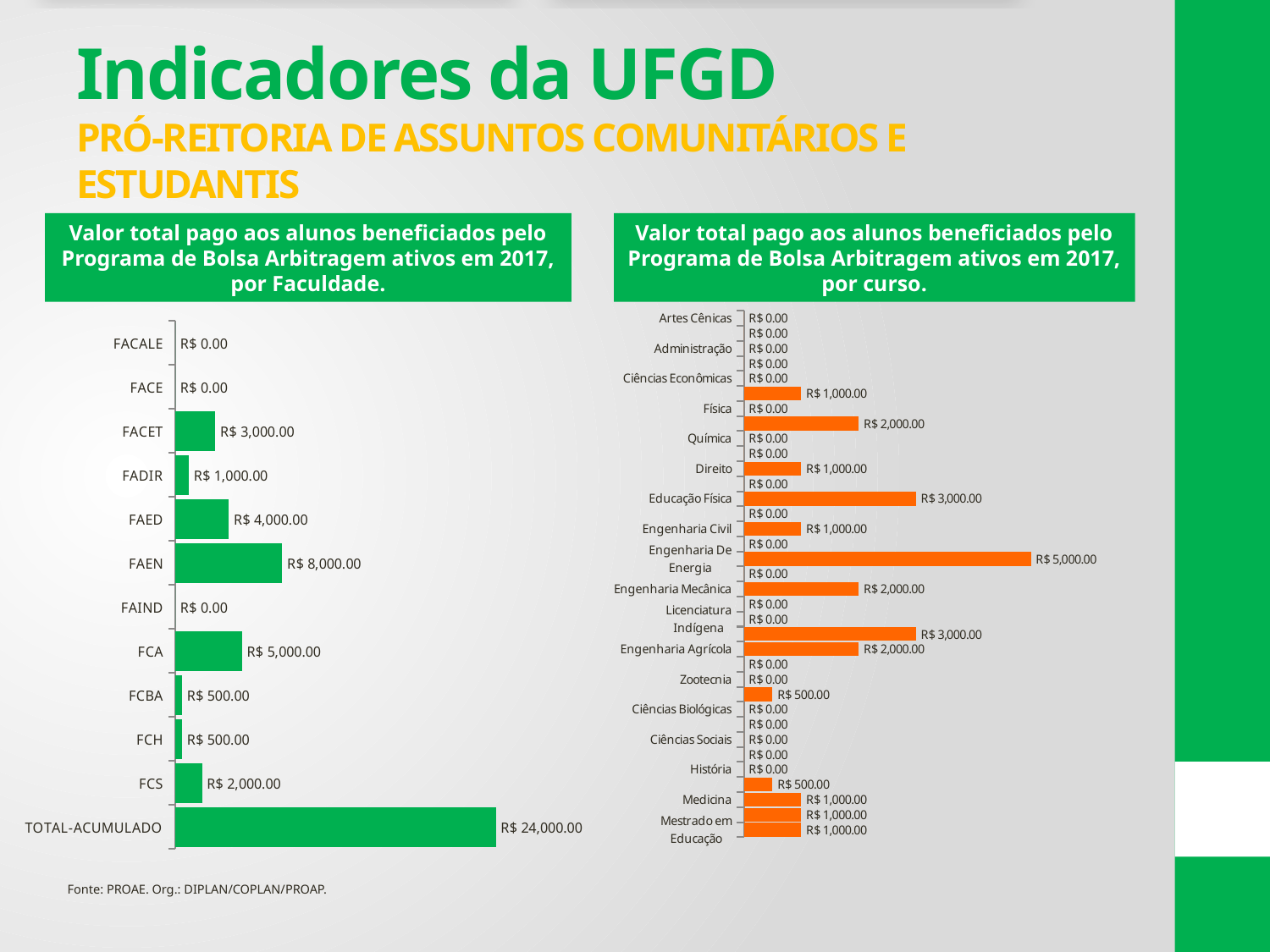
In the left chart (por Faculdade), which faculty, excluding TOTAL-ACUMULADO, has the highest value? FAEN In the left chart (por Faculdade), what is the value for TOTAL-ACUMULADO? R$ 24,000.00 In the left chart (por Faculdade), how many categories are plotted, including TOTAL-ACUMULADO? 12 In the left chart (por Faculdade), what is the difference between the values for FAEN and FCA? R$ 3,000.00 In the left chart (por Faculdade), what is the value for FAEN? R$ 8,000.00 In the left chart (por Faculdade), what is the value for FACET? R$ 3,000.00 What kind of chart is the left chart (por Faculdade)? Bar chart What colour are the bars in the right chart (por curso)? Orange In the left chart (por Faculdade), which is larger, the value for FAED or the value for FCS? FAED In the left chart (por Faculdade), how many faculties have a value of R$ 0.00? 3 In the right chart (por curso), what is the largest value labelled on any bar? R$ 5,000.00 In the left chart (por Faculdade), what is the value for FCBA? R$ 500.00